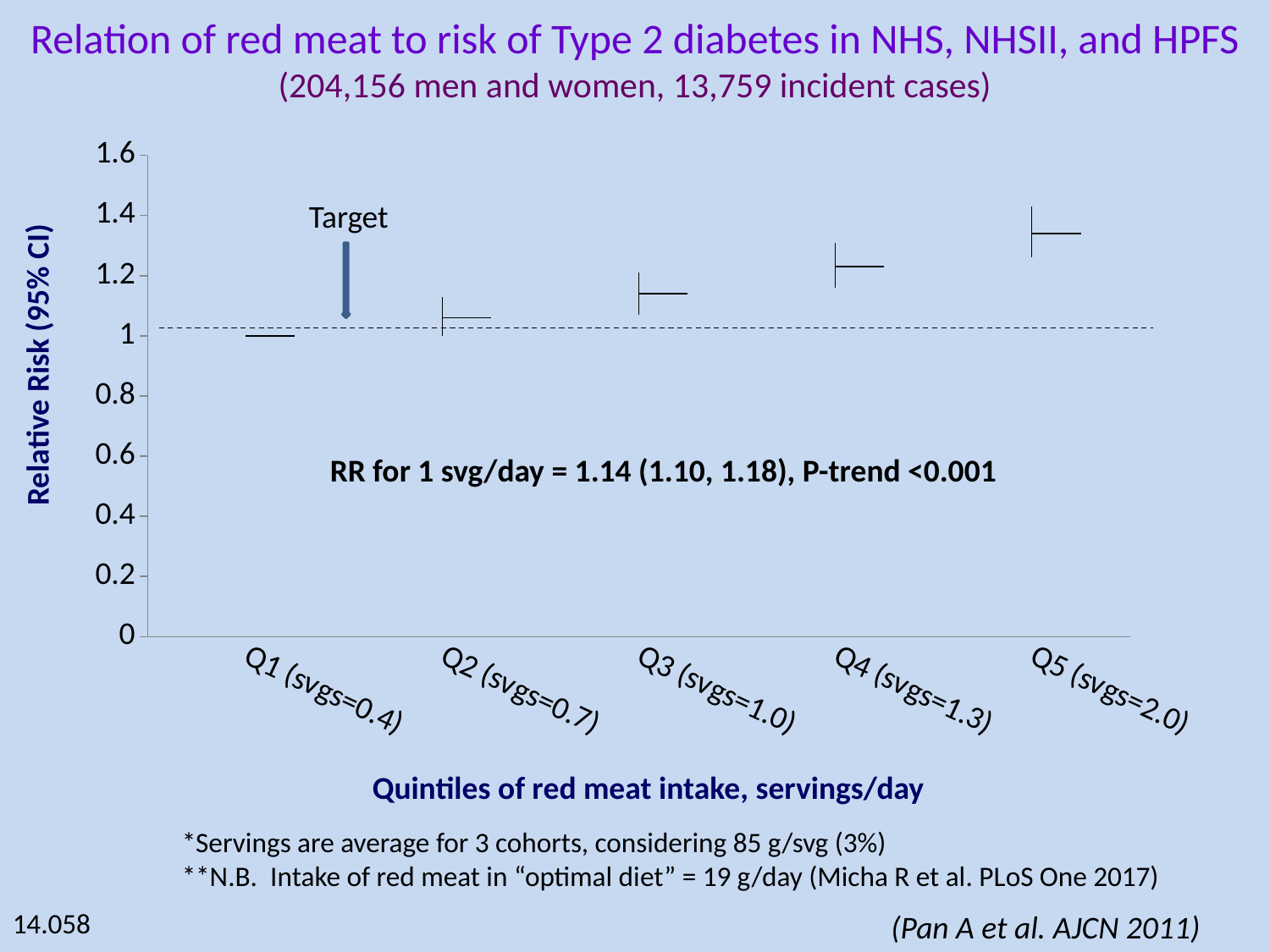
Is the relative risk for Q4 (svgs=1.3) greater or less than 1.4? less What is the label of the y axis? Relative Risk (95% CI) Which has a higher relative risk, Q5 (svgs=2.0) or Q3 (svgs=1.0)? Q5 (svgs=2.0) Which quintile has the highest relative risk? Q5 (svgs=2.0) How many quintiles of red meat intake are plotted on the x axis? 5 Which quintile has the lowest relative risk? Q1 (svgs=0.4) Which has a higher relative risk, Q4 (svgs=1.3) or Q2 (svgs=0.7)? Q4 (svgs=1.3) Is the relative risk for Q2 (svgs=0.7) greater or less than 1.2? less Is the relative risk for Q5 (svgs=2.0) greater or less than 1.2? greater Do the relative risk values rise or fall from Q1 to Q5? rise What is the label of the x axis? Quintiles of red meat intake, servings/day